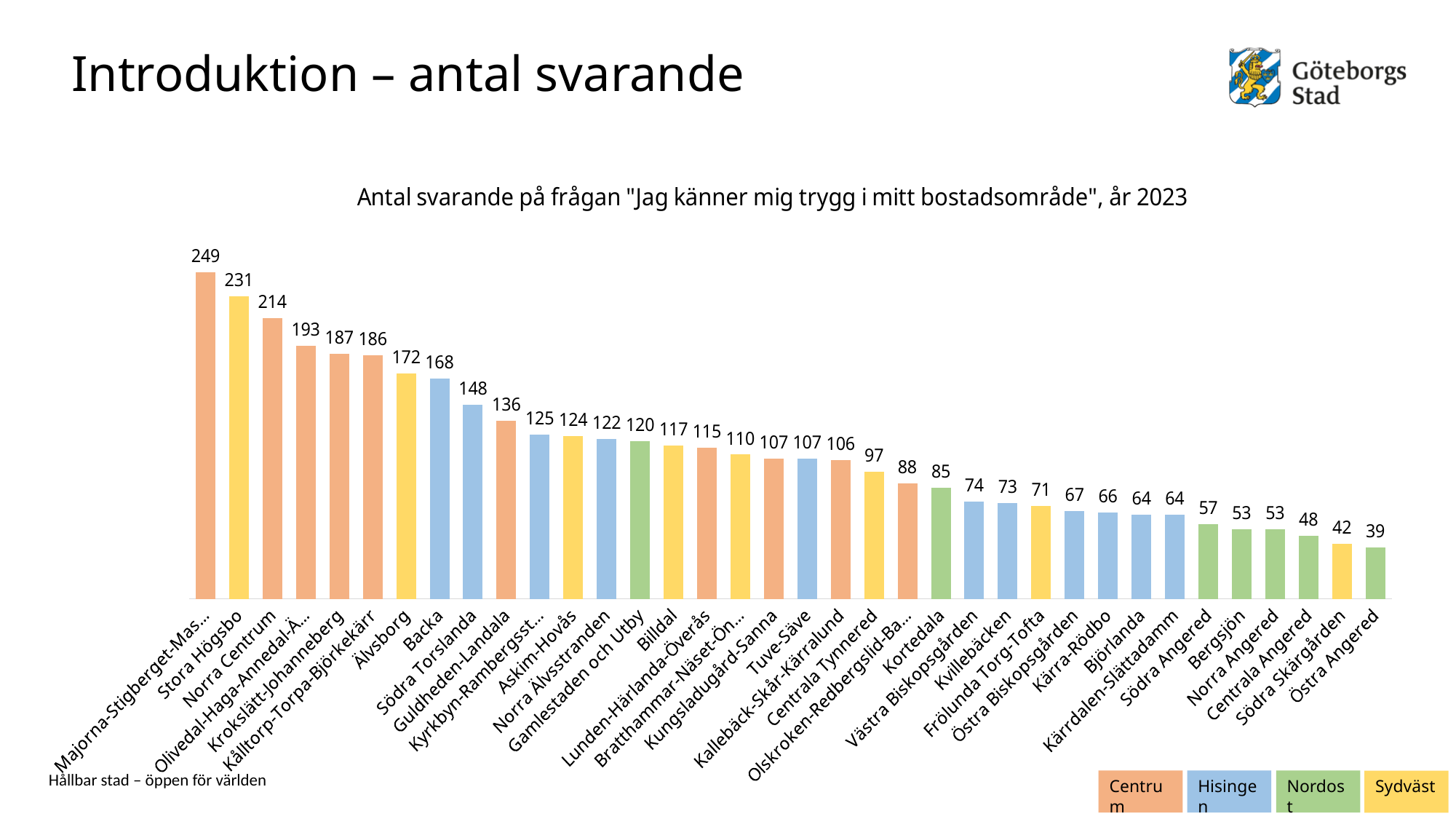
How many respondents are shown for Backa? 168 What is the difference between the values for Stora Högsbo and Norra Centrum? 17 Do the values rise or fall from left to right along the x axis? Fall What is the value for Kortedala? 85 What is the difference between the values for Södra Torslanda and Guldheden-Landala? 12 Which area has the highest number of respondents? Majorna-Stigberget-Mas... What type of chart is shown on the slide? Bar chart What is the value for Frölunda Torg-Tofta? 71 How many entries does the legend list? 4 Which area has the lowest number of respondents? Östra Angered Which has a larger value, Älvsborg or Billdal? Älvsborg How many areas (bars) are shown in the chart? 36